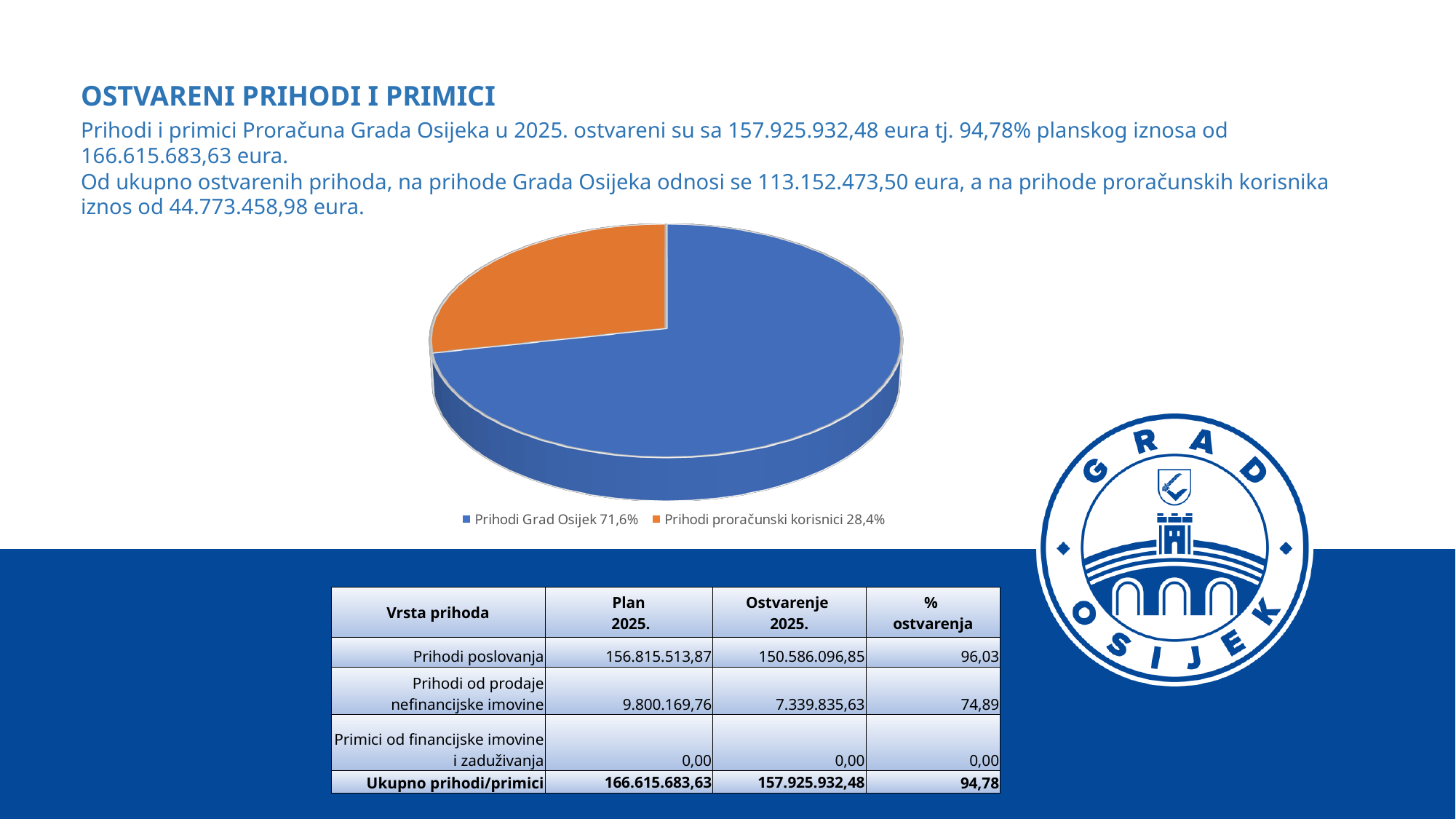
What colour is the "Prihodi proračunski korisnici" slice in the pie chart? orange What colour is the "Prihodi Grad Osijek" slice in the pie chart? blue What share of the pie does "Prihodi proračunski korisnici" represent? 28,4% By how many percentage points does the "Prihodi Grad Osijek" share exceed the "Prihodi proračunski korisnici" share? 43,2 Which slice of the pie chart is the largest? Prihodi Grad Osijek Which is larger in the pie chart: "Prihodi Grad Osijek" or "Prihodi proračunski korisnici"? Prihodi Grad Osijek What share of the pie does "Prihodi Grad Osijek" represent? 71,6% How many slices does the pie chart have? 2 Is the share for "Prihodi proračunski korisnici" greater or less than 50%? less Which slice of the pie chart is the smallest? Prihodi proračunski korisnici What kind of chart is shown on the slide? pie chart